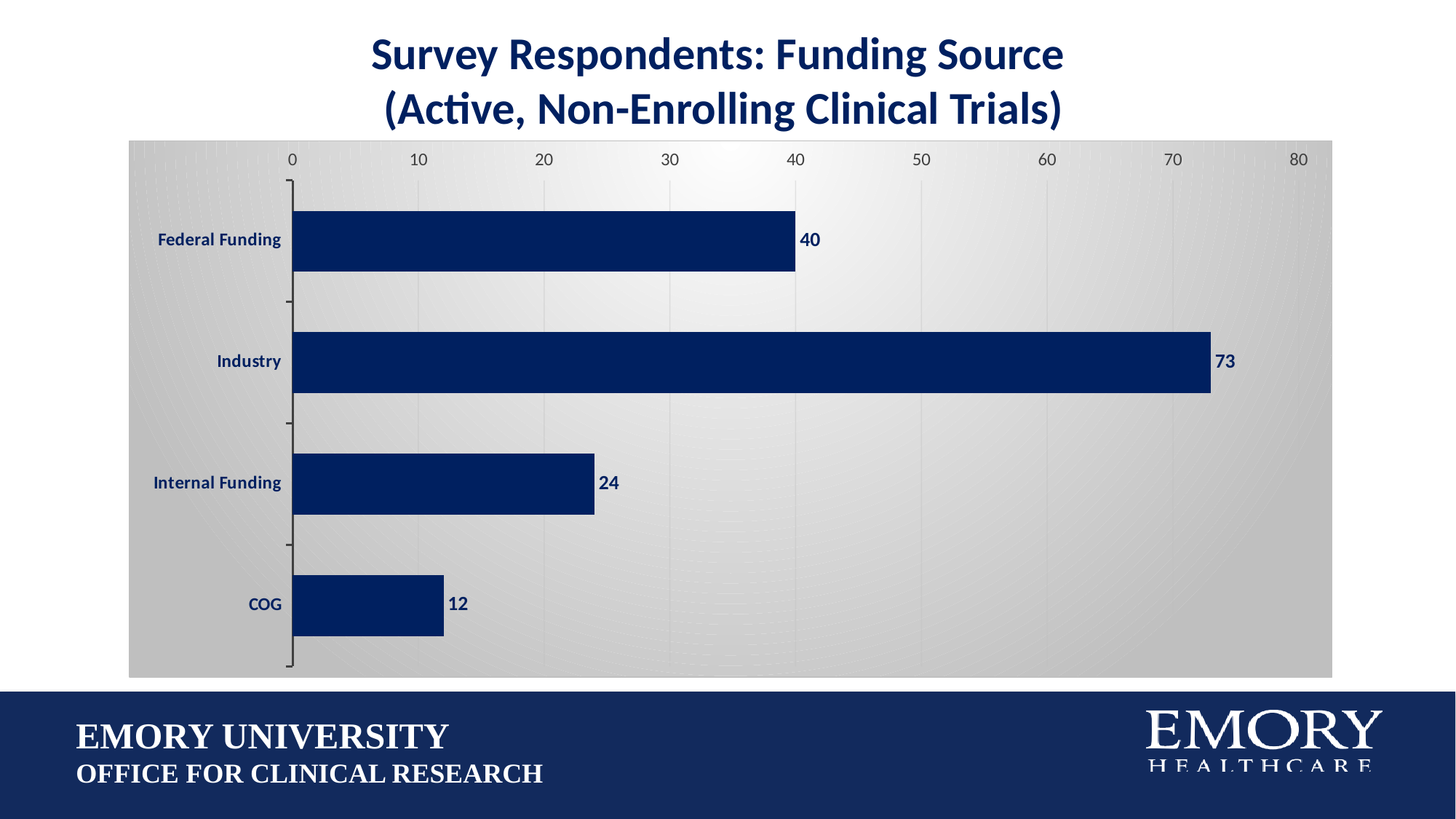
What is the difference between the values for Internal Funding and COG? 12 What is the value for Federal Funding? 40 What kind of chart is shown on the slide? Bar chart What is the title of the chart? Survey Respondents: Funding Source (Active, Non-Enrolling Clinical Trials) What is the value for Internal Funding? 24 How many funding source categories are shown in the chart? 4 Which funding source has the lowest value? COG What is the value for COG? 12 Which is larger, the value for Federal Funding or the value for Internal Funding? Federal Funding What is the value for Industry? 73 What is the difference between the values for Industry and Federal Funding? 33 Which funding source has the highest value? Industry